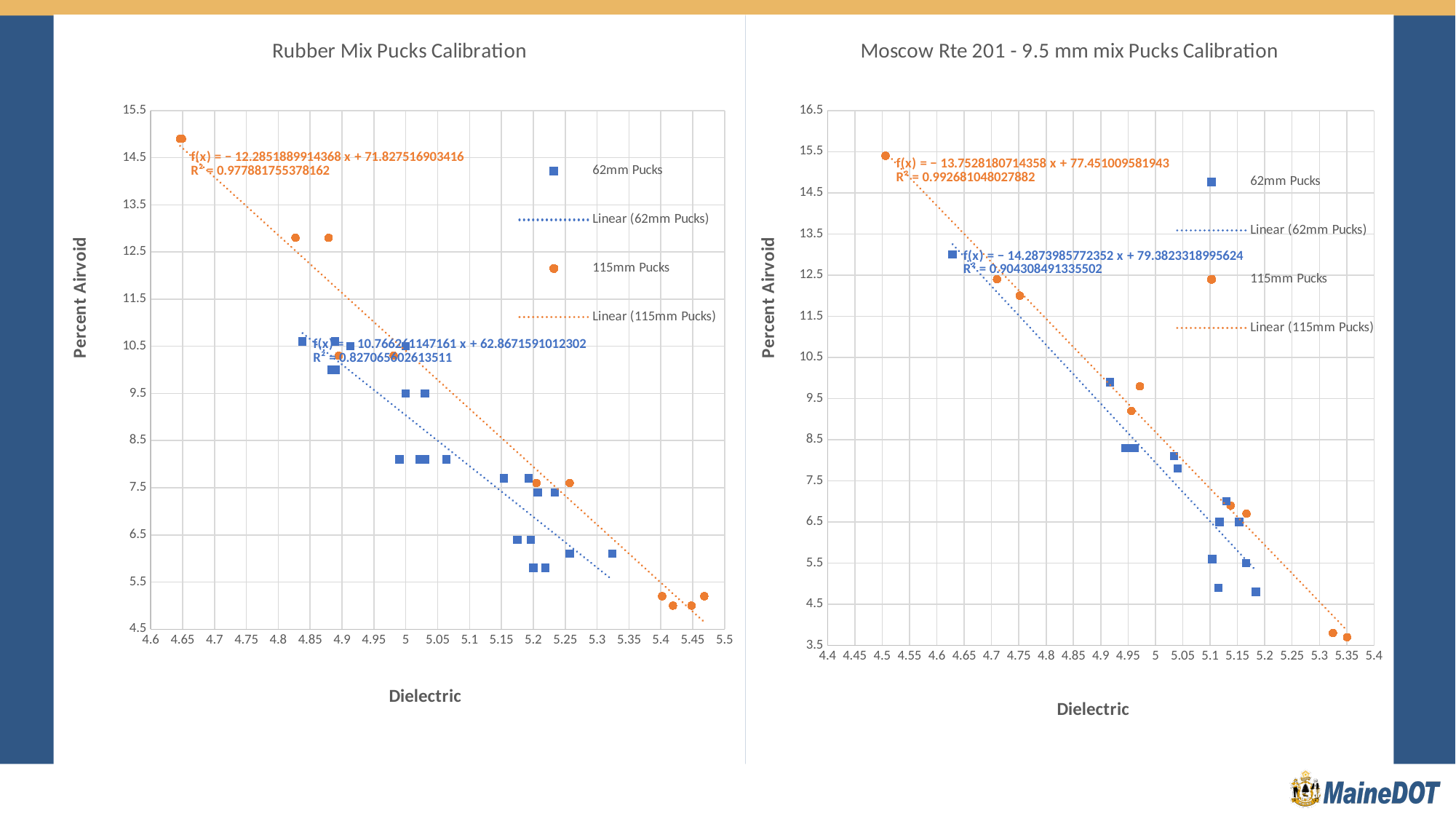
In the Rubber Mix Pucks Calibration chart, what is the R² value shown for the 62mm Pucks trendline? 0.827065602613511 In the Rubber Mix Pucks Calibration chart, what is the R² value shown for the 115mm Pucks trendline? 0.977881755378162 In the Rubber Mix Pucks Calibration chart, do the percent airvoid values rise or fall as dielectric increases? fall In the Rubber Mix Pucks Calibration chart, is the percent airvoid of the 115mm puck point at dielectric 4.65 greater or less than 14.5? greater What kind of chart is the Rubber Mix Pucks Calibration chart? scatter chart In the Moscow Rte 201 - 9.5 mm mix Pucks Calibration chart, which trendline has the higher R² value, 62mm Pucks or 115mm Pucks? 115mm Pucks In the Rubber Mix Pucks Calibration chart, what is the slope shown in the trendline equation for the 115mm Pucks? −12.2851889914368 What is the label of the x axis on the Moscow Rte 201 - 9.5 mm mix Pucks Calibration chart? Dielectric In the Moscow Rte 201 - 9.5 mm mix Pucks Calibration chart, is the percent airvoid of the 115mm puck point at dielectric 5.35 greater or less than 4.5? less In the Moscow Rte 201 - 9.5 mm mix Pucks Calibration chart, what is the R² value shown for the 62mm Pucks trendline? 0.904308491335502 In the Moscow Rte 201 - 9.5 mm mix Pucks Calibration chart, what is the R² value shown for the 115mm Pucks trendline? 0.992681048027882 How many entries does the legend of the Moscow Rte 201 - 9.5 mm mix Pucks Calibration chart list? 4